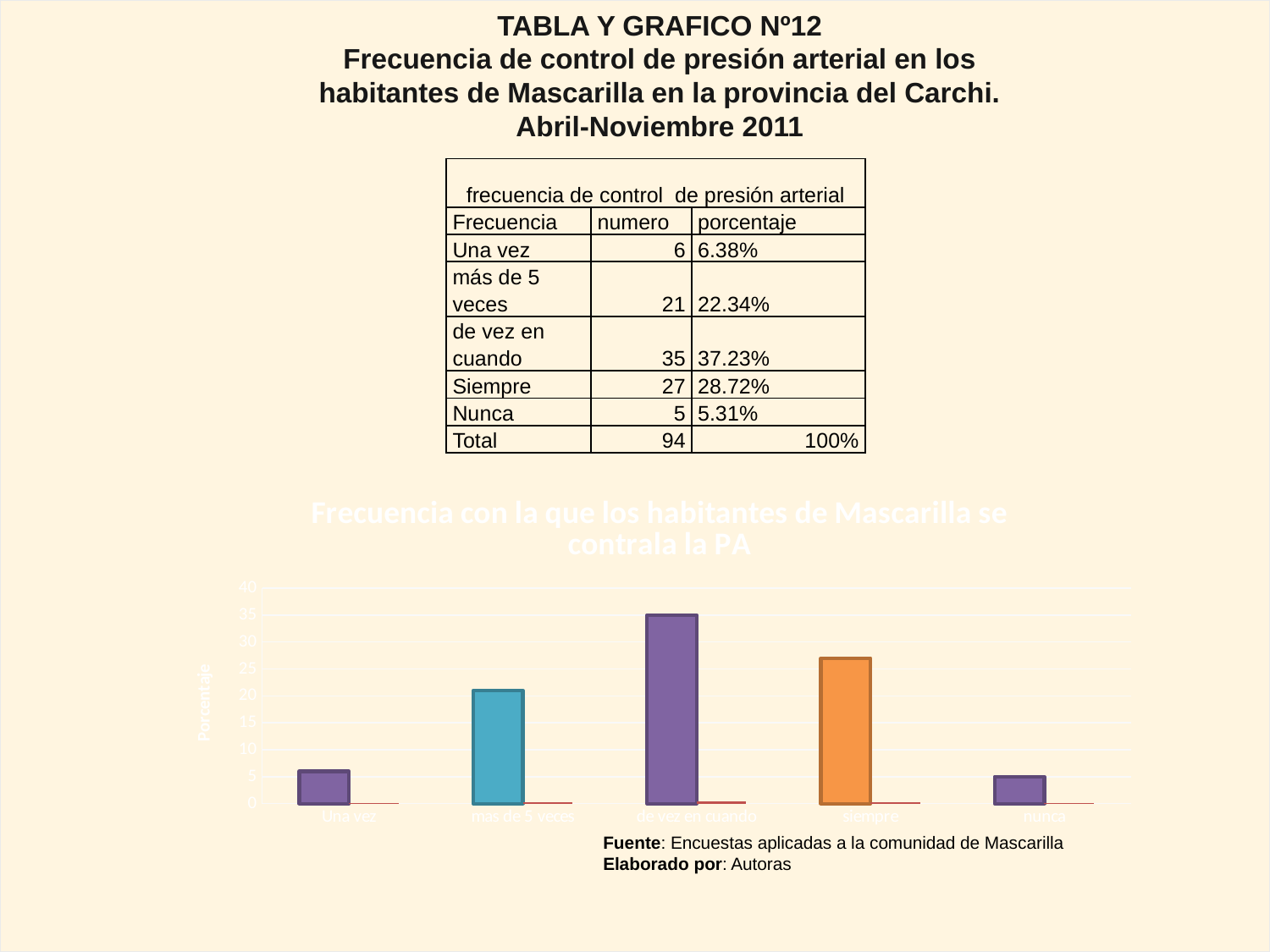
Which category has the shortest bar in the chart? nunca How many categories are plotted on the x axis of the bar chart? 5 What kind of chart is shown on the slide? bar chart What is the highest value shown on the chart's y axis? 40 Is the value for 'siempre' greater or less than 25? greater Is the value for 'más de 5 veces' greater or less than 25? less Which category has the tallest bar in the chart? de vez en cuando What value does the bar for 'nunca' reach? 5 Do the bar values rise or fall from 'Una vez' to 'de vez en cuando'? rise Which bar is taller, 'siempre' or 'más de 5 veces'? siempre Is the value for 'Una vez' greater or less than 10? less What value does the bar for 'de vez en cuando' reach? 35